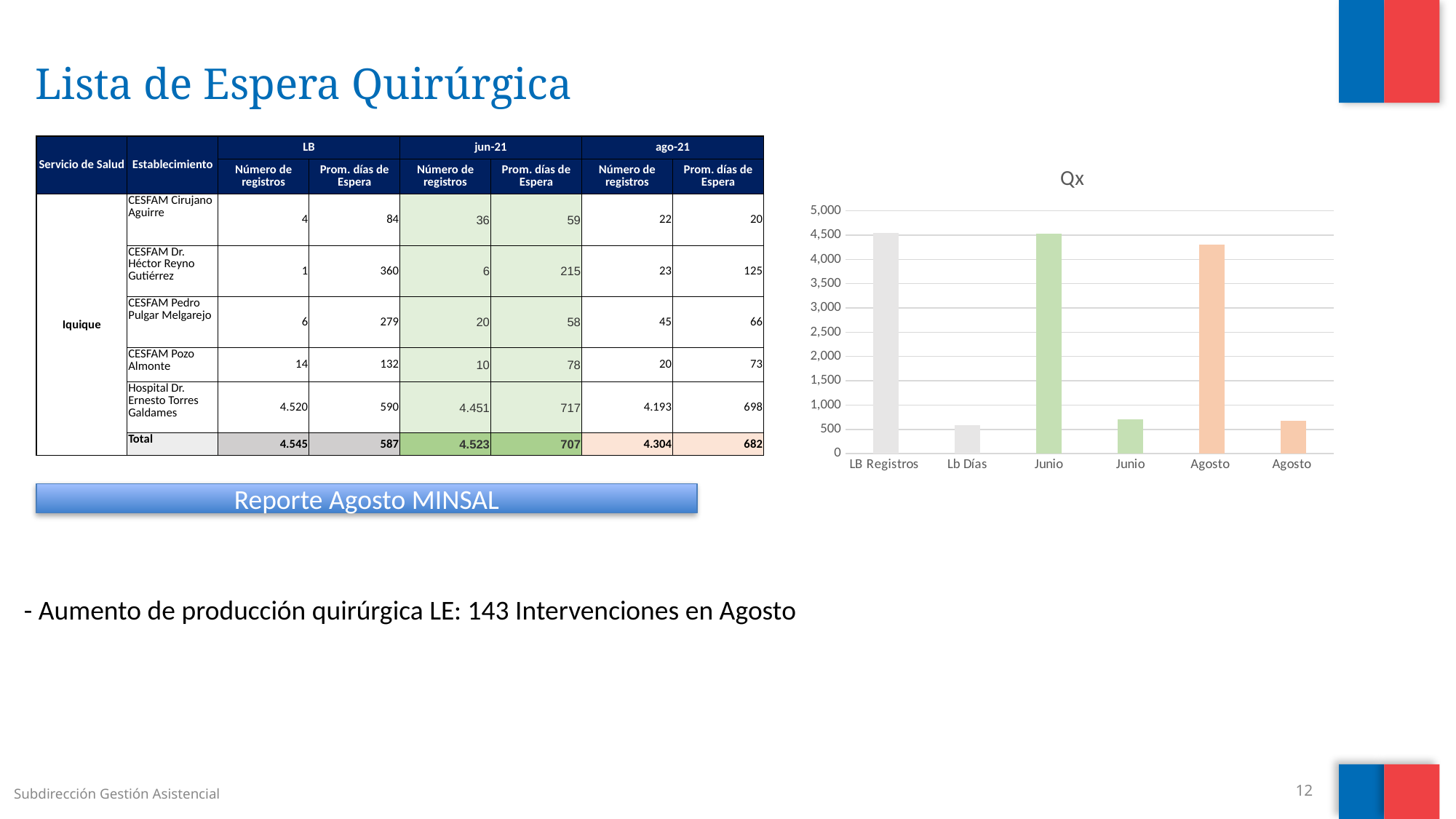
What kind of chart is the Qx chart? bar chart In the Qx chart, is the first Junio bar (third from the left) greater or less than 4,000? greater In the Qx chart, which is larger, LB Registros or Lb Días? LB Registros What is the highest value shown on the vertical axis of the Qx chart? 5,000 In the Qx chart, is the first Agosto bar (fifth from the left) greater or less than 4,000? greater In the Qx chart, which is larger, the LB Registros bar or the first Agosto bar? LB Registros What is the title of the chart on the right of the slide? Qx In the Qx chart, is the second Junio bar (fourth from the left) greater or less than 1,000? less How many bars are plotted in the Qx chart? 6